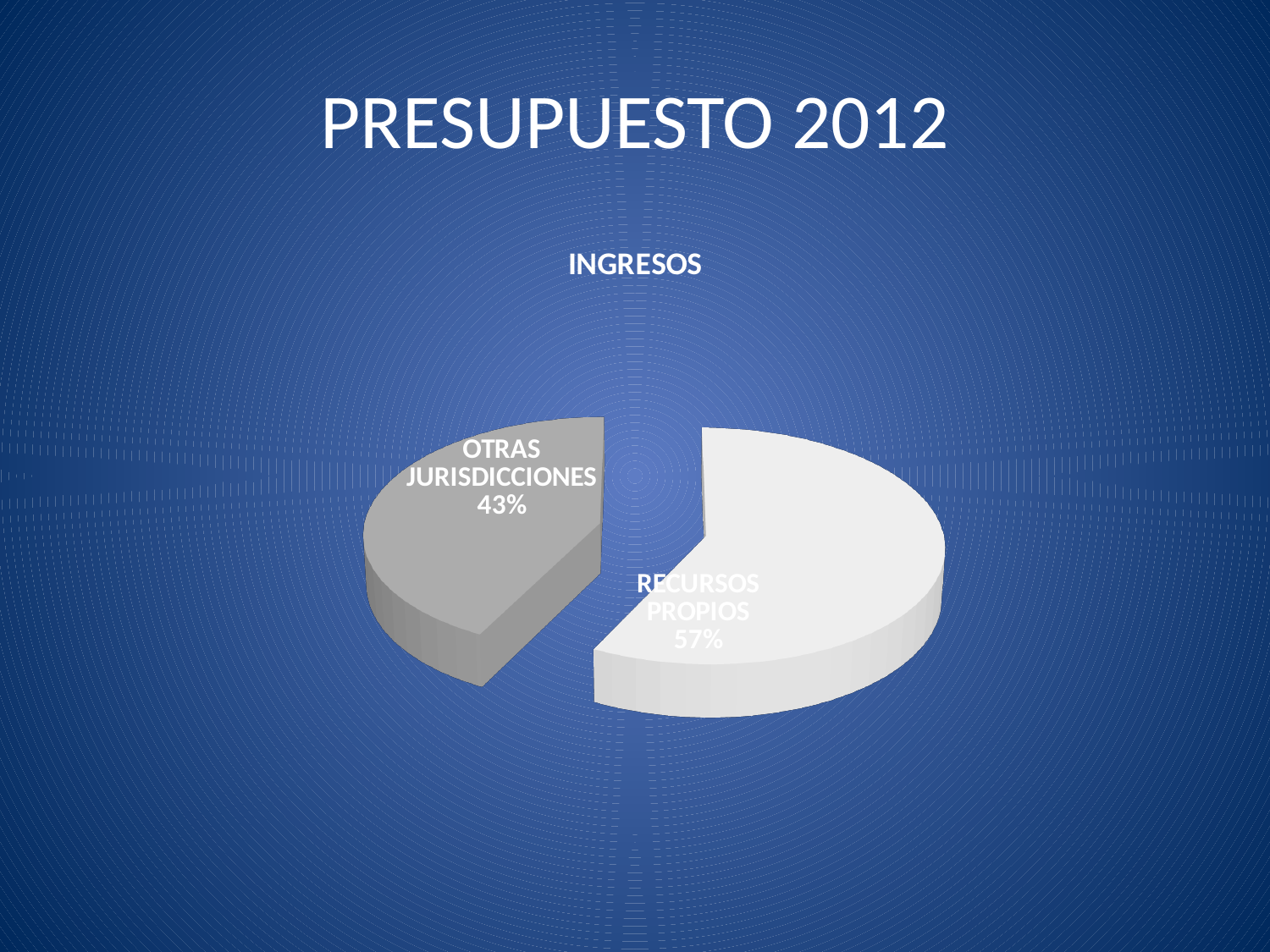
Is the share for OTRAS JURISDICCIONES greater or less than 50%? less Which slice is the largest in the pie chart? RECURSOS PROPIOS What is the title of the chart? INGRESOS Which slice is the smallest in the pie chart? OTRAS JURISDICCIONES How many slices does the pie chart have? 2 What kind of chart is shown on the slide? Pie chart What colour is the OTRAS JURISDICCIONES slice? Grey What share of the pie does RECURSOS PROPIOS represent? 57% Which is larger, RECURSOS PROPIOS or OTRAS JURISDICCIONES? RECURSOS PROPIOS What share of the pie does OTRAS JURISDICCIONES represent? 43% What is the difference in percentage points between RECURSOS PROPIOS and OTRAS JURISDICCIONES? 14%